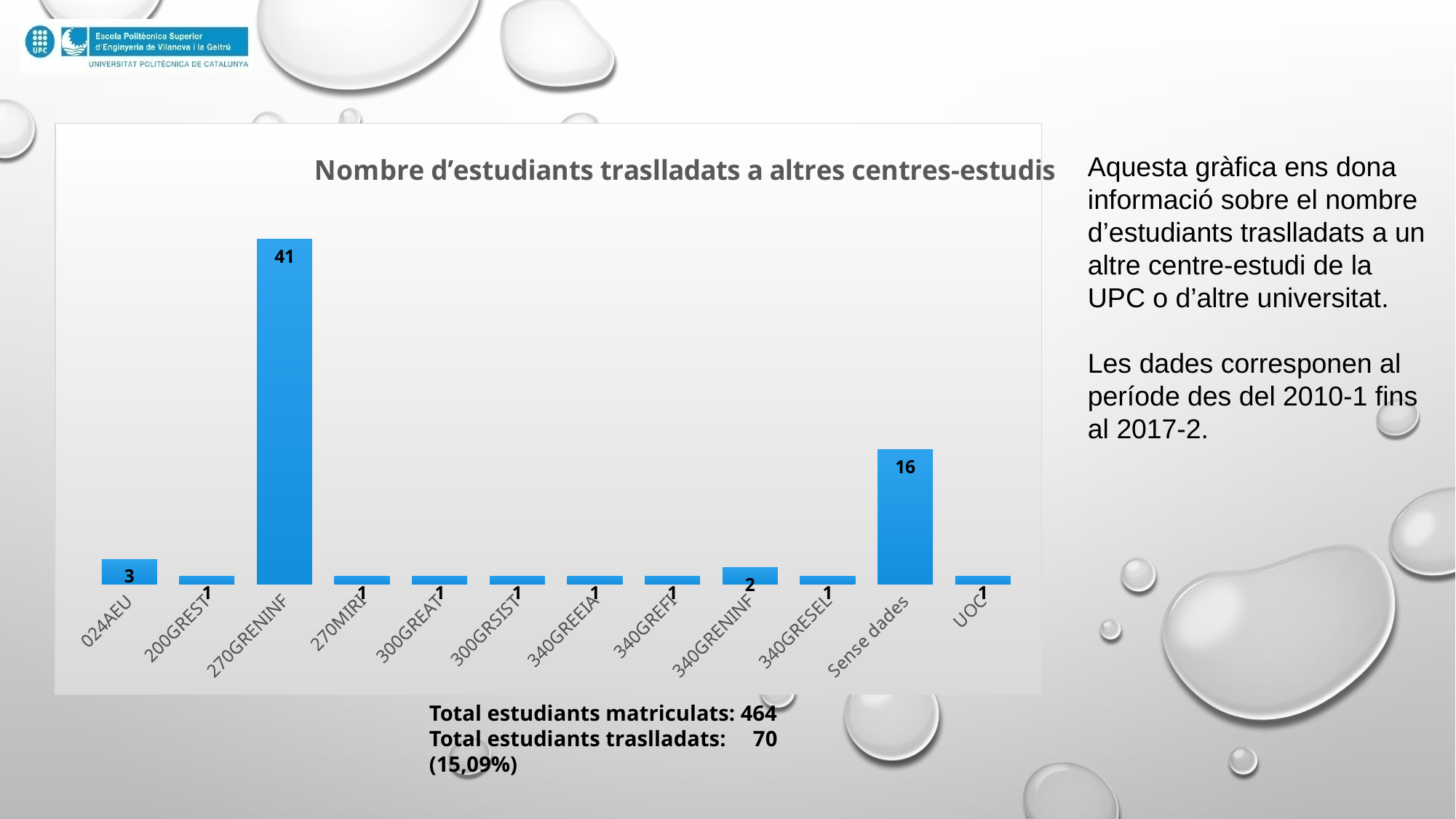
What is the difference between the values for Sense dades and 024AEU? 13 What is the value for 270GRENINF? 41 What is the value for UOC? 1 What is the difference between the values for 270GRENINF and Sense dades? 25 What is the value for Sense dades? 16 Which category has the highest value? 270GRENINF What is the title of the chart? Nombre d’estudiants traslladats a altres centres-estudis What kind of chart is shown on the slide? Bar chart What is the value for 340GRENINF? 2 What is the value for 024AEU? 3 How many categories are shown on the x axis? 12 Which is larger, the value for 024AEU or the value for 340GRENINF? 024AEU